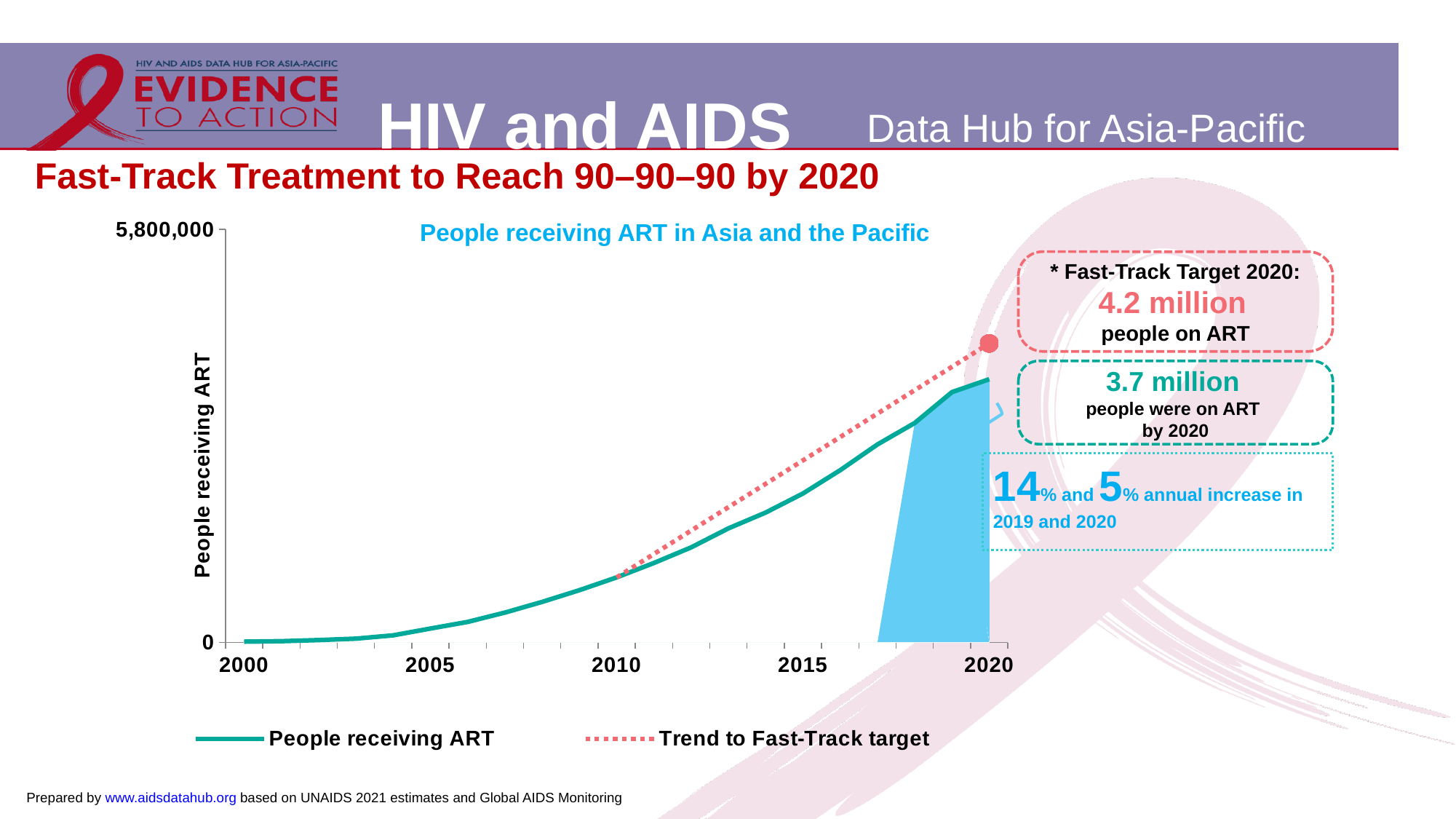
What annual increase in people receiving ART does the slide report for 2019? 14% Which is larger: the Fast-Track Target 2020 or the number of people actually on ART by 2020? Fast-Track Target 2020 Does the number of people receiving ART rise or fall from 2000 to 2020? Rise Is the value for people receiving ART in 2020 greater or less than 5,800,000? less What is the title of the chart? People receiving ART in Asia and the Pacific What annual increase in people receiving ART does the slide report for 2020? 5% According to the slide, how many people were on ART by 2020? 3.7 million How many series does the chart legend list? 2 What kind of chart is shown on the slide? Line chart What is the difference between the Fast-Track Target 2020 (4.2 million) and the number of people on ART by 2020 (3.7 million)? 0.5 million What are the two series named in the chart legend? People receiving ART; Trend to Fast-Track target What is the Fast-Track Target 2020 for people on ART shown on the slide? 4.2 million